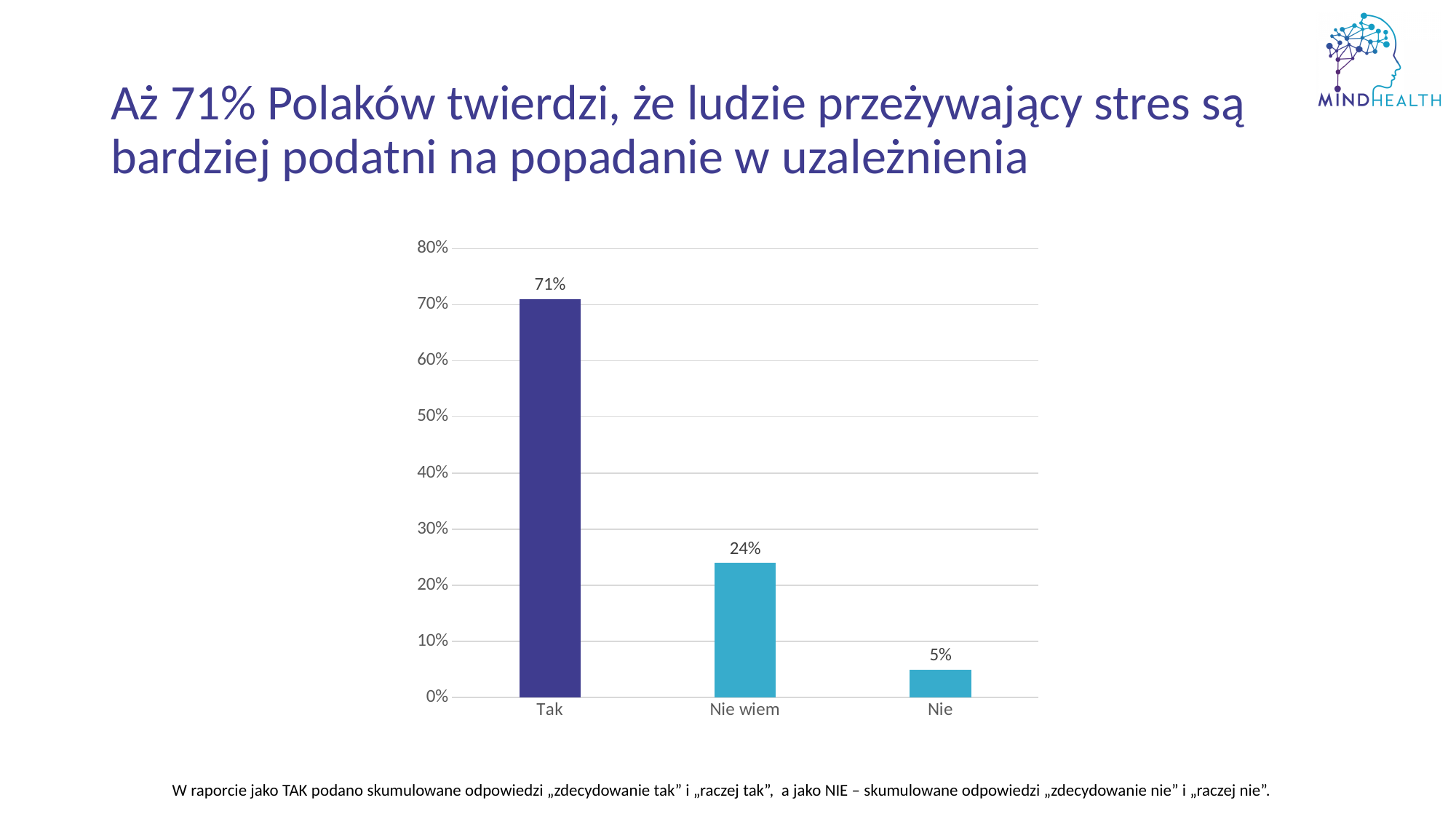
Is the value for "Tak" greater or less than 60%? greater What kind of chart is shown on the slide? bar chart What is the value for "Tak"? 71% What is the difference between the values for "Tak" and "Nie wiem"? 47% Which is larger, the value for "Nie wiem" or the value for "Nie"? Nie wiem What is the value for "Nie"? 5% How many categories are shown on the x axis? 3 Which category has the lowest value? Nie What is the value for "Nie wiem"? 24% Which category has the highest value? Tak What is the difference between the values for "Nie wiem" and "Nie"? 19% Do the values rise or fall from left to right along the x axis? fall